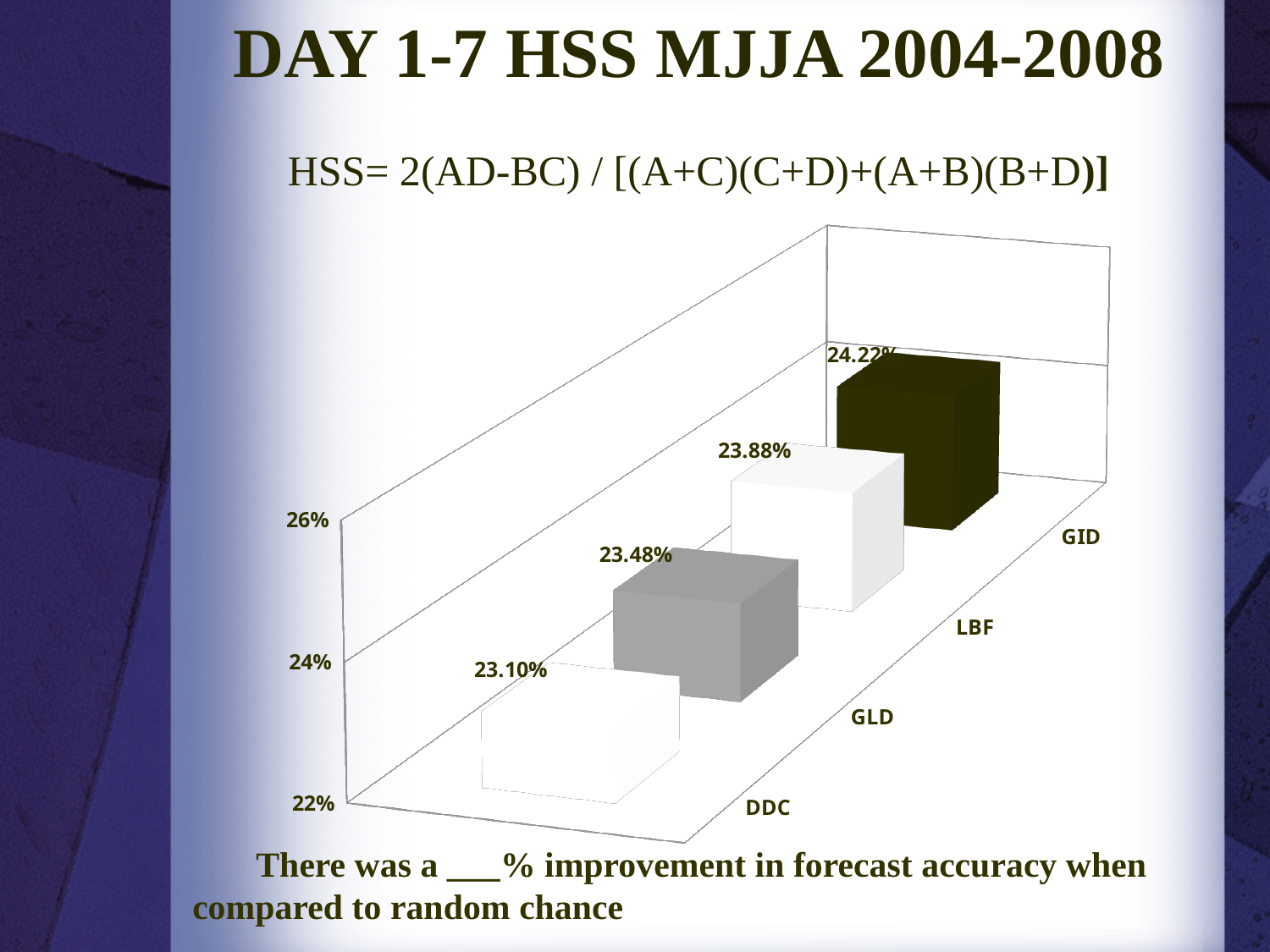
Which category has the lowest HSS value? DDC What is the HSS value for GLD? 23.48% What is the HSS value for LBF? 23.88% Which has a higher HSS value, LBF or GLD? LBF What kind of chart is shown on the slide? bar chart What is the HSS value for GID? 24.22% How many categories are shown in the chart? 4 Which category has the highest HSS value? GID What is the HSS value for DDC? 23.10% Is the value for GID greater or less than 24%? greater Do the values rise or fall going from DDC to GID along the category axis? rise What is the difference between the HSS values for GID and DDC? 1.12%